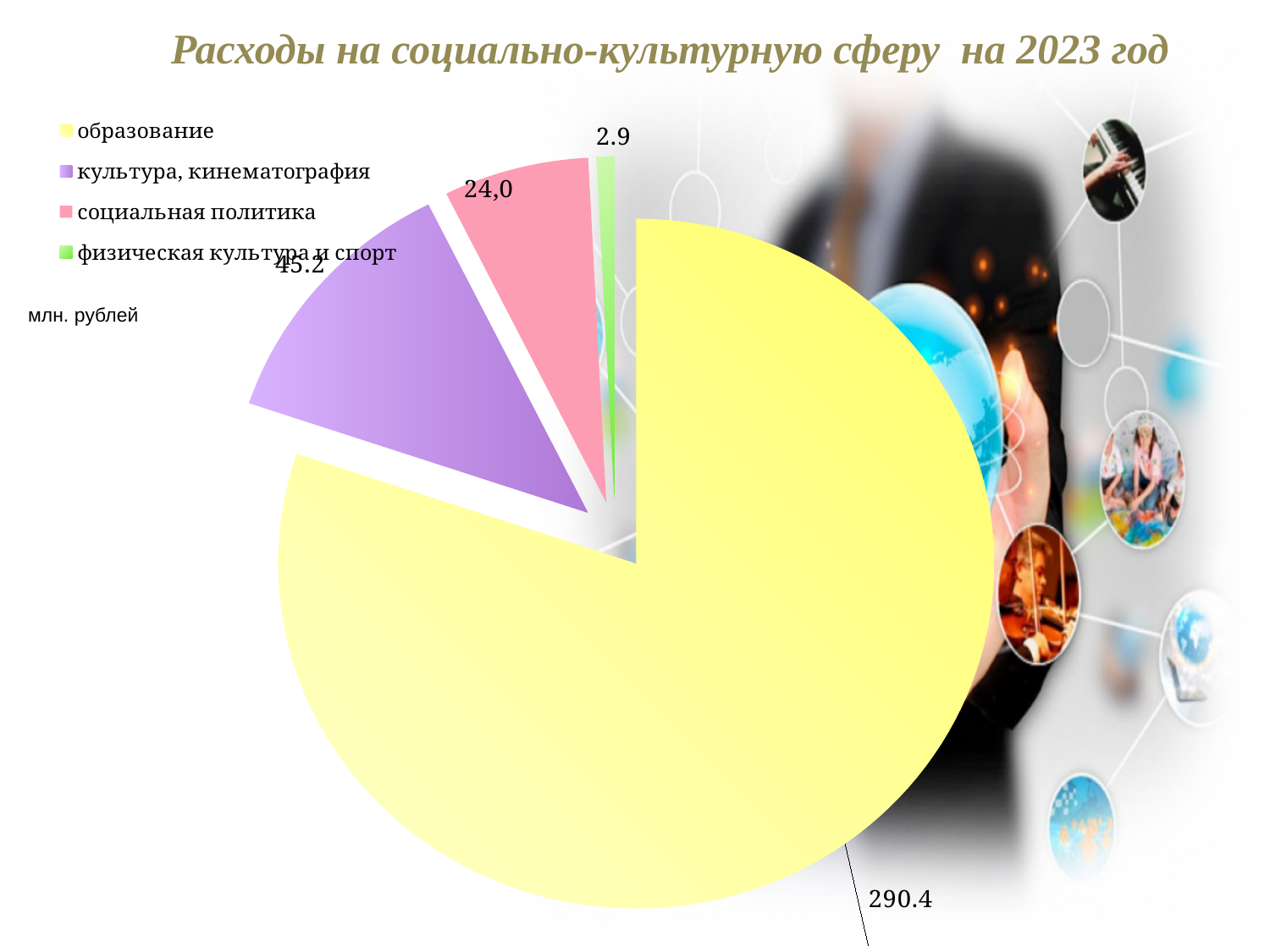
What is the difference between the values for культура, кинематография and социальная политика? 21.2 Which category has the largest slice of the pie? образование What kind of chart is shown on the slide? pie chart How many categories does the legend list? 4 What is the difference between the values for образование and культура, кинематография? 245.2 What is the value for культура, кинематография? 45.2 What is the title of the chart? Расходы на социально-культурную сферу на 2023 год Which is larger, the value for социальная политика or the value for физическая культура и спорт? социальная политика What is the value for образование? 290.4 What is the value for социальная политика? 24,0 Which category has the smallest slice of the pie? физическая культура и спорт What is the value for физическая культура и спорт? 2.9